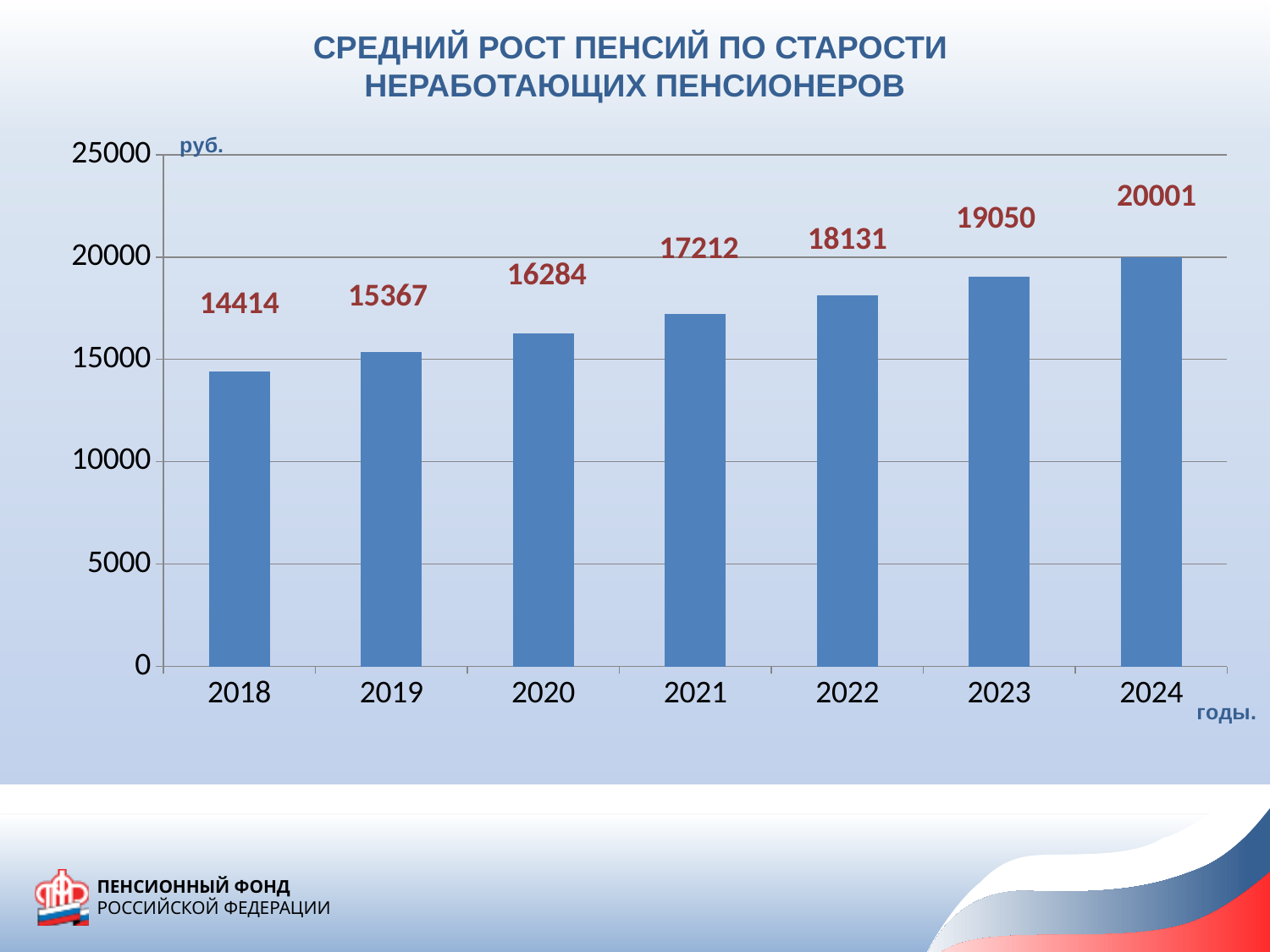
Is the value for 2021 greater or less than 15000? greater What kind of chart is shown on the slide? bar chart Which is larger, the value for 2022 or the value for 2023? 2023 What is the difference between the values for 2020 and 2019? 917 What is the value for 2018? 14414 What is the value for 2024? 20001 What is the value for 2021? 17212 How many years are shown on the x axis? 7 Do the values rise or fall from 2018 to 2024? rise Which year has the lowest value? 2018 Which year has the highest value? 2024 What is the difference between the values for 2024 and 2018? 5587